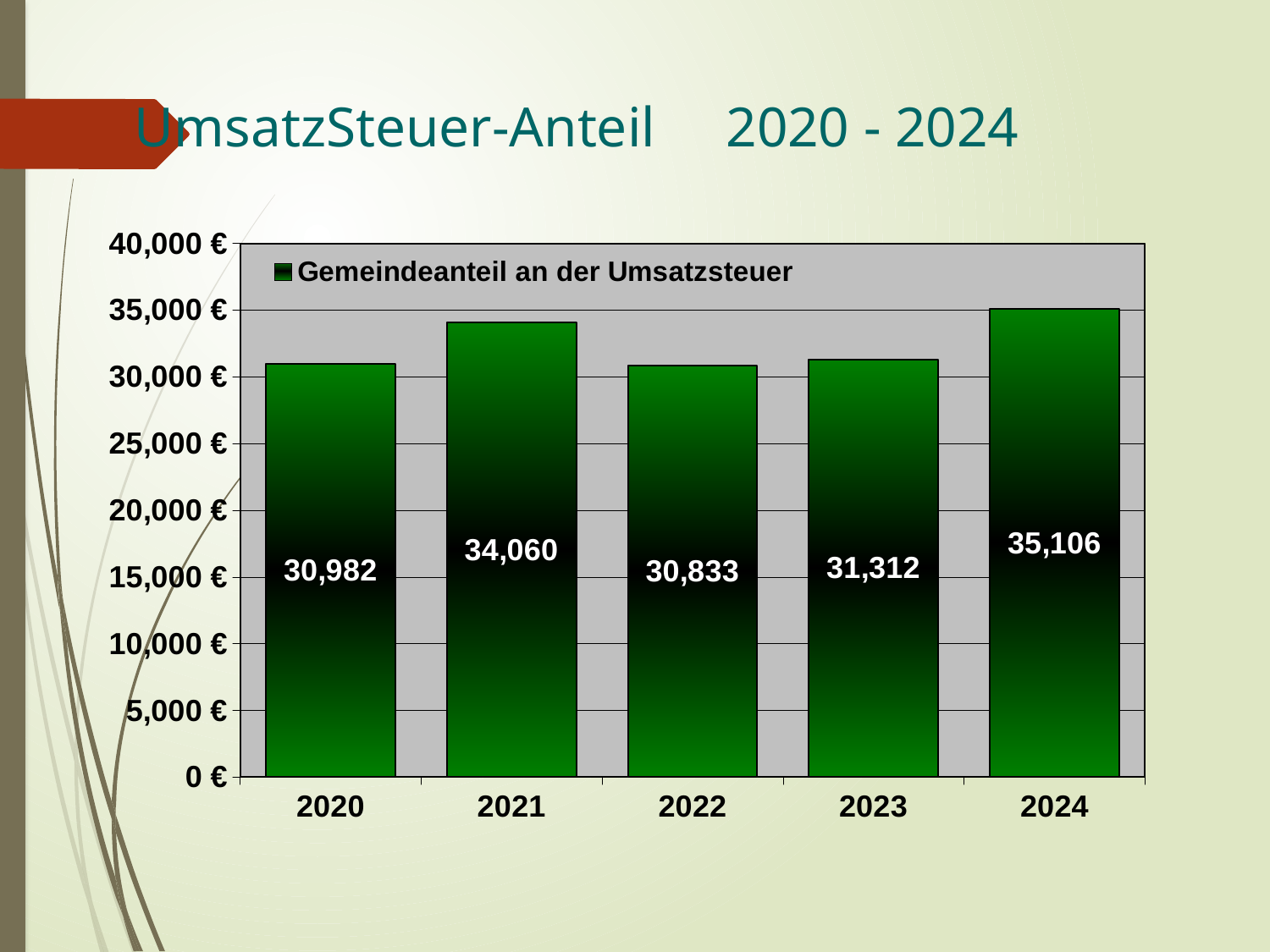
How many years are shown on the x axis? 5 What is the value for 2020? 30,982 What series name does the legend show? Gemeindeanteil an der Umsatzsteuer What is the difference between the values for 2024 and 2020? 4,124 Which year has the lowest value? 2022 What is the value for 2022? 30,833 Which is larger, the value for 2021 or the value for 2023? 2021 Which year has the highest value? 2024 What is the value for 2021? 34,060 What kind of chart is shown on the slide? bar chart What is the value for 2024? 35,106 What is the value for 2023? 31,312